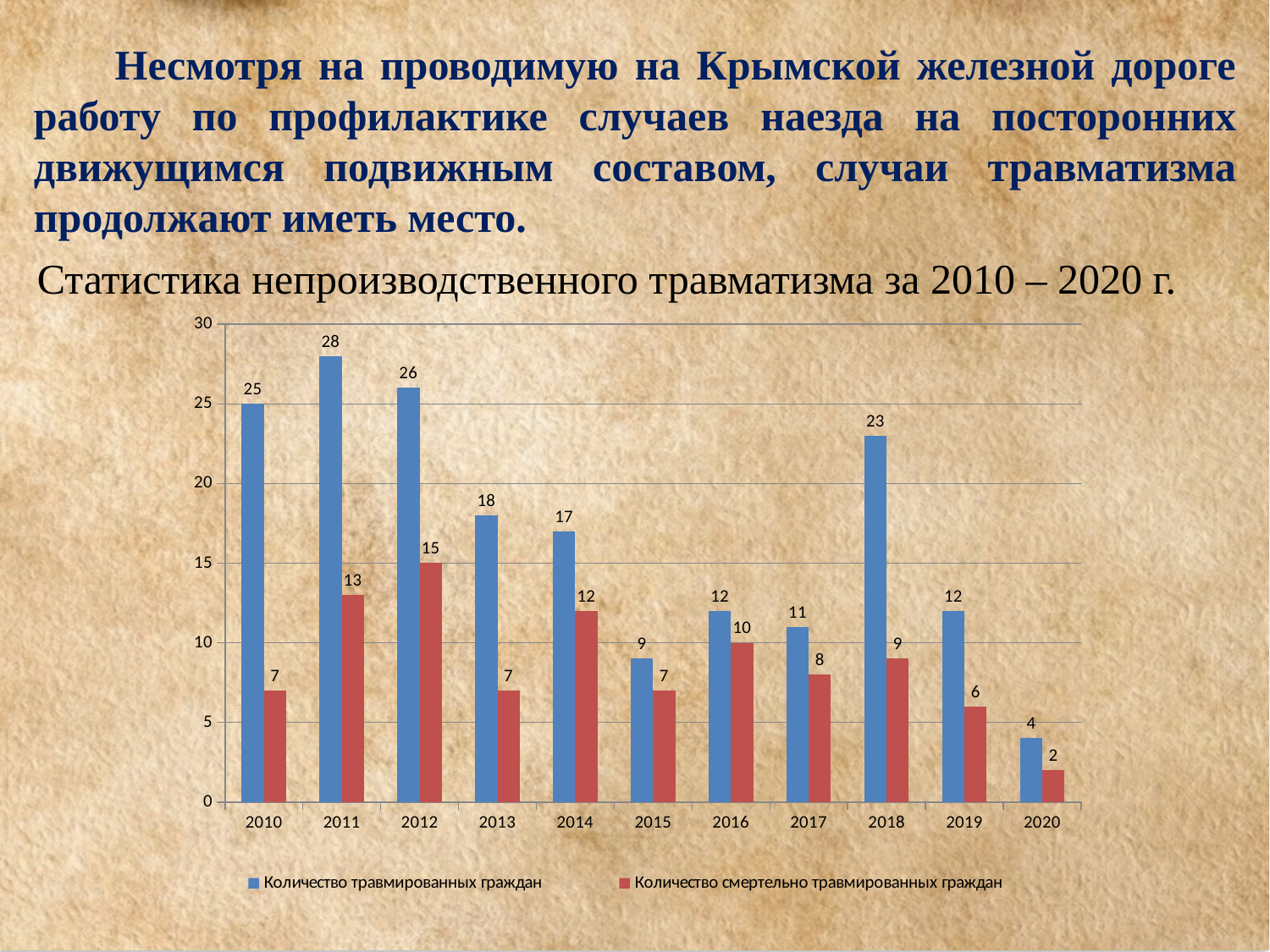
Does the number of injured citizens rise or fall from 2018 to 2020? fall What type of chart is shown on the slide? bar chart How many years are shown on the x axis of the chart? 11 Is the number of injured citizens in 2010 greater or less than 20? greater What colour are the bars for the series 'Количество смертельно травмированных граждан'? red Which year had more injured citizens, 2013 or 2019? 2013 In which year was the number of injured citizens highest? 2011 What was the number of injured citizens (Количество травмированных граждан) in 2012? 26 How many series does the chart legend list? 2 What is the difference between the number of injured citizens and the number of fatally injured citizens in 2018? 14 In which year was the number of fatally injured citizens lowest? 2020 What was the number of fatally injured citizens (Количество смертельно травмированных граждан) in 2014? 12